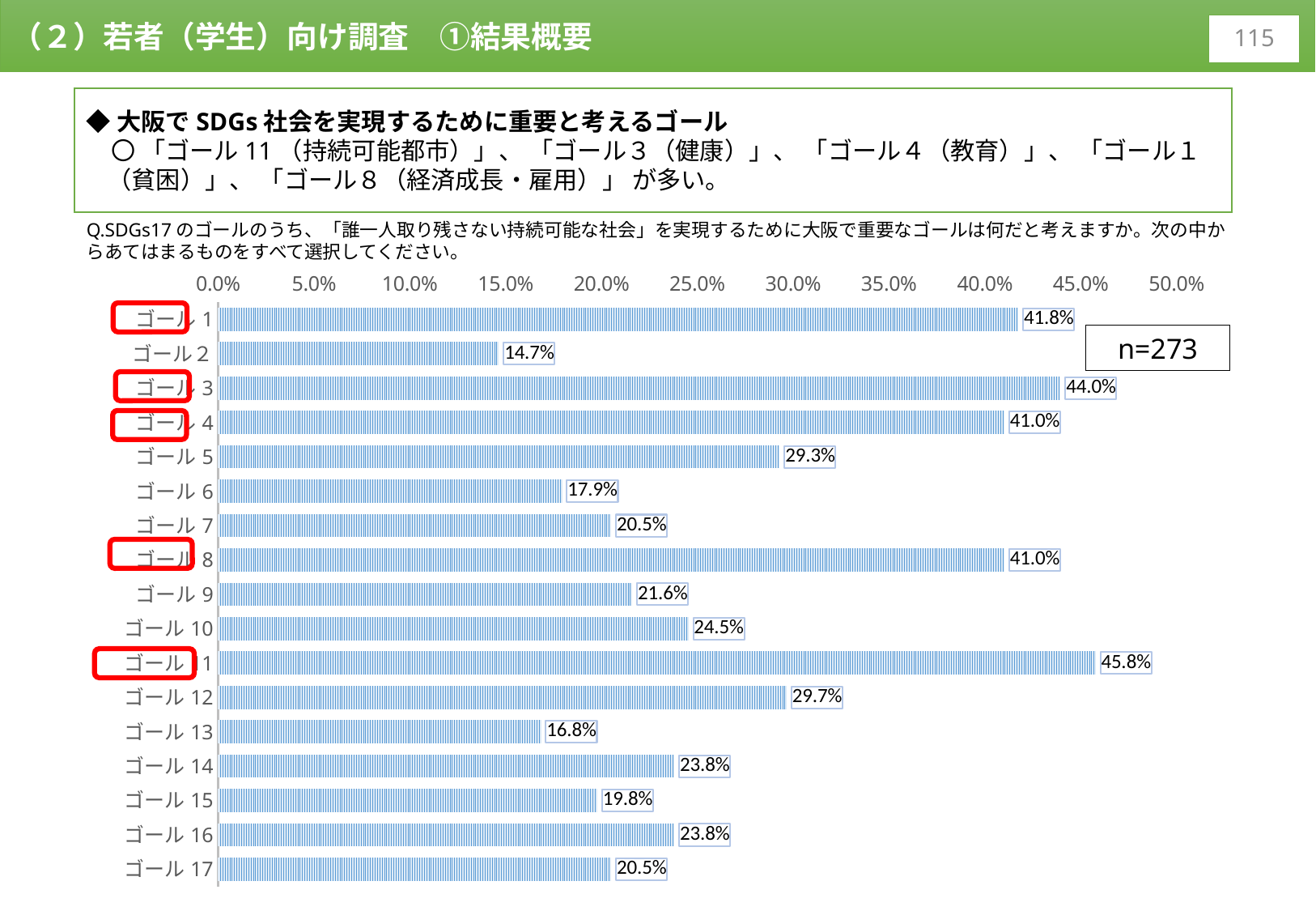
Which is larger, the value for ゴール 5 or the value for ゴール 12? ゴール 12 What is the difference between the values for ゴール 11 and ゴール 3? 1.8% Is the value for ゴール 10 greater or less than 20.0%? greater What is the value for ゴール 11? 45.8% What is the difference between the values for ゴール 1 and ゴール 2? 27.1% What is the value for ゴール 13? 16.8% Which goal has the highest value? ゴール 11 How many goals (categories) are shown in the chart? 17 What kind of chart is shown on the slide? bar chart Which goal has the lowest value? ゴール 2 What is the value for ゴール 3? 44.0% What is the sample size (n) shown on the chart? n=273